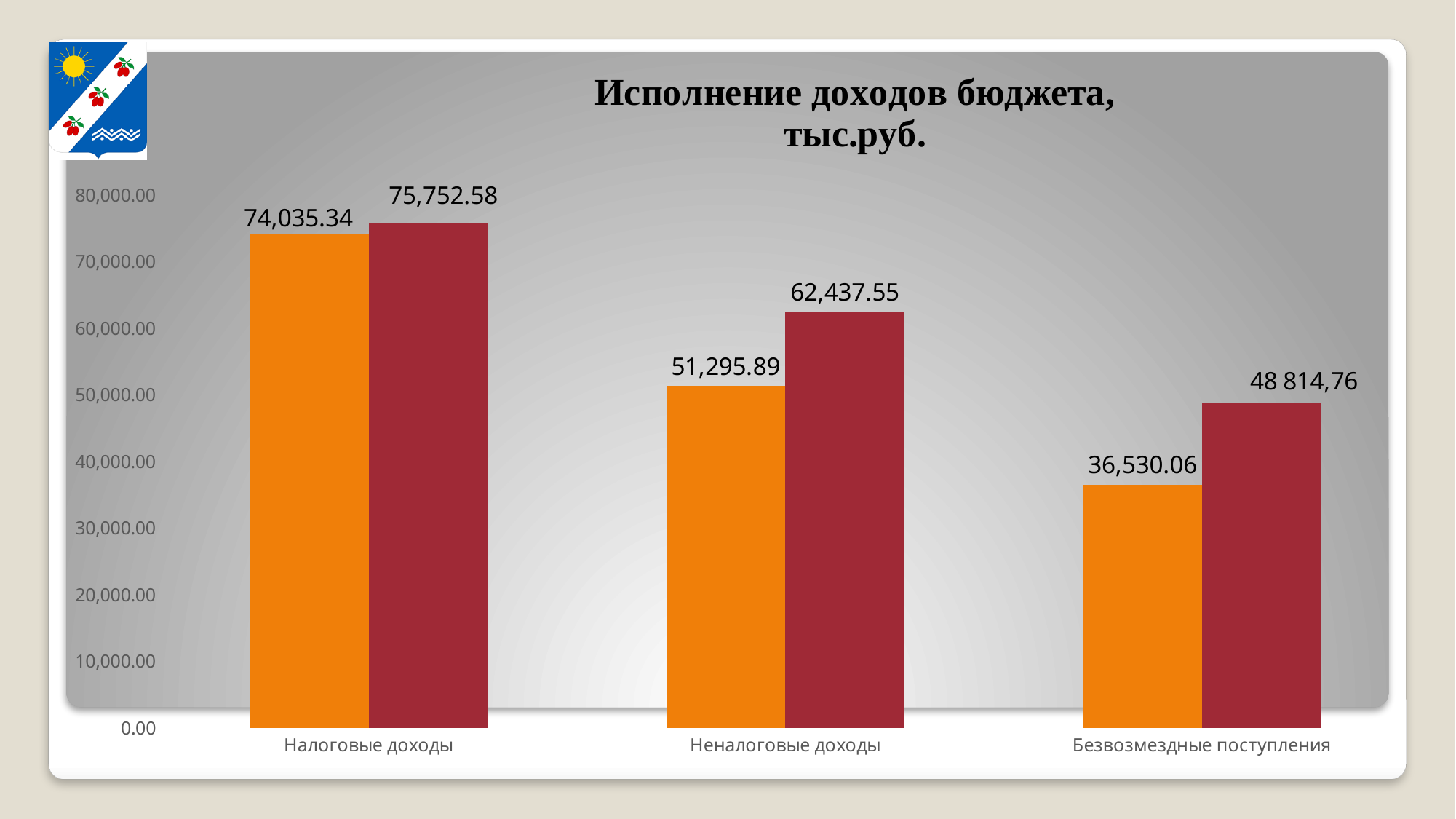
What kind of chart is shown on the slide? bar chart What is the value of the orange bar for Налоговые доходы? 74,035.34 Which category has the lowest orange bar? Безвозмездные поступления Which is larger for Безвозмездные поступления, the orange bar or the dark red bar? the dark red bar What is the value of the orange bar for Безвозмездные поступления? 36,530.06 What is the value of the dark red bar for Неналоговые доходы? 62,437.55 Do the orange bars rise or fall from left to right across the categories? fall What is the value of the dark red bar for Безвозмездные поступления? 48 814,76 Which category has the highest dark red bar? Налоговые доходы What is the difference between the dark red and orange bars for Неналоговые доходы? 11,141.66 How many categories are shown on the x axis of the chart? 3 What is the title of the chart? Исполнение доходов бюджета, тыс.руб.